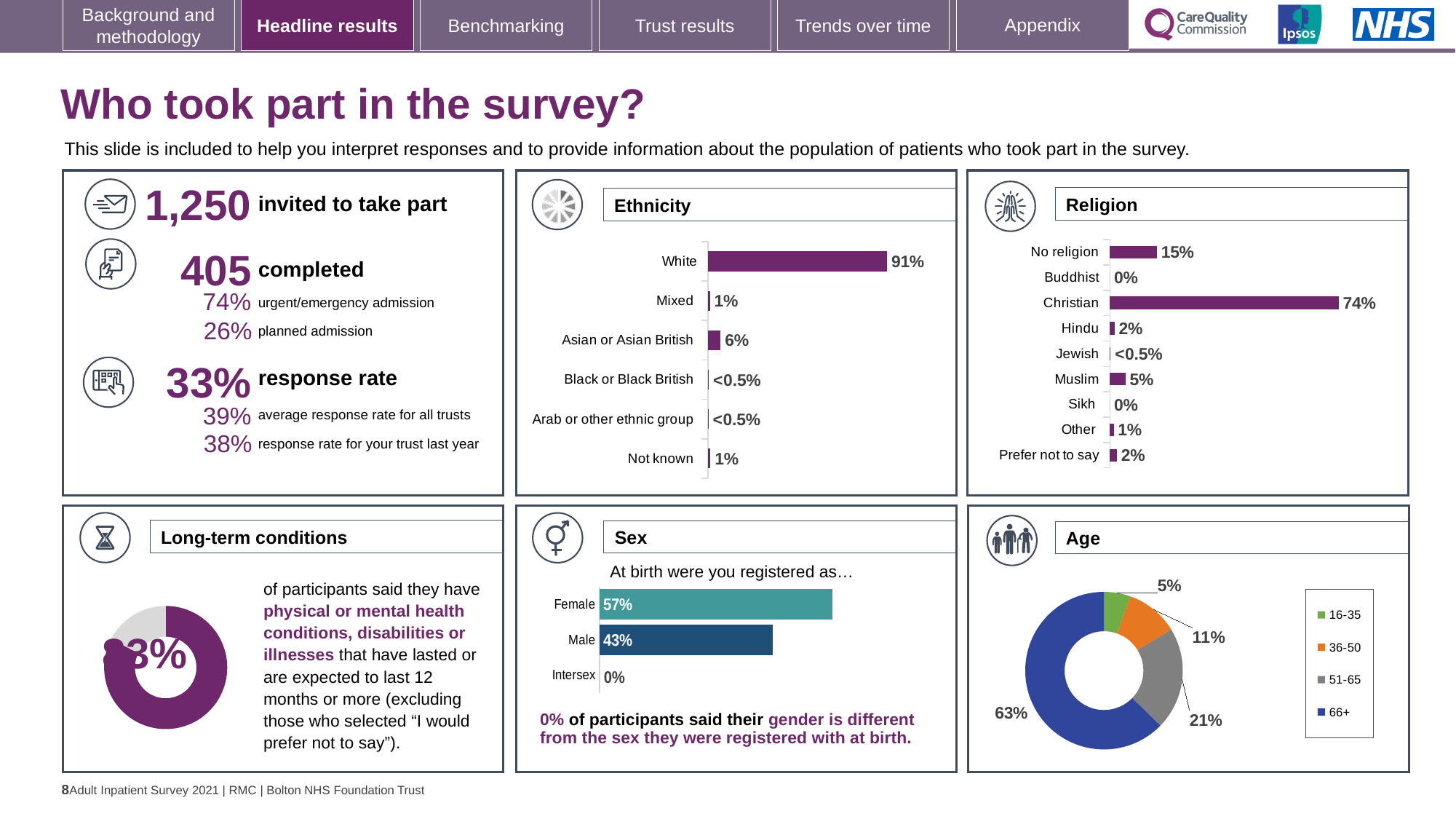
How many ethnicity categories are shown in the Ethnicity chart? 6 In the Sex chart, what is the difference between the Female and Male values? 14 percentage points In the Religion chart, what is the value for No religion? 15% In the Sex chart, what percentage of participants were registered as Female at birth? 57% In the Ethnicity chart, which category has the highest value? White In the Ethnicity chart, what is the value for Asian or Asian British? 6% How many age groups does the legend of the Age chart list? 4 In the Ethnicity chart, what percentage of participants were White? 91% In the Religion chart, what is the difference between the Christian and No religion values? 59 percentage points In the Religion chart, which is larger, Muslim or Hindu? Muslim In the Age chart, which age group has the largest share? 66+ In the Religion chart, what percentage of participants were Christian? 74%